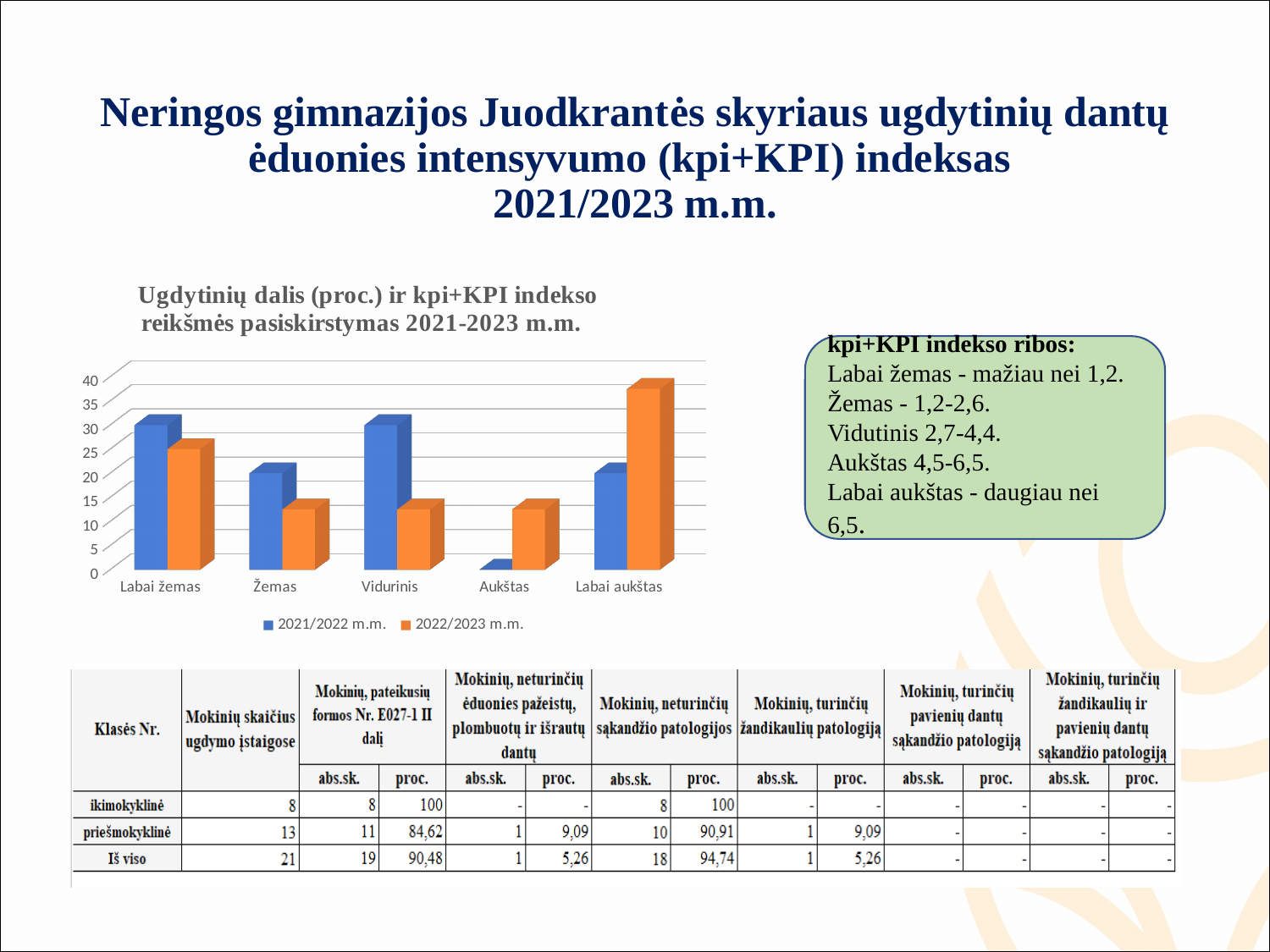
What kind of chart is shown on the slide? bar chart Is the 2022/2023 m.m. value for Labai aukštas greater or less than 30? greater Is the 2021/2022 m.m. value for Aukštas greater or less than 5? less Is the 2022/2023 m.m. value for Žemas greater or less than 20? less Which category has the highest value for the 2022/2023 m.m. series? Labai aukštas Which category has the lowest value for the 2021/2022 m.m. series? Aukštas For the Labai aukštas category, which series has the larger value, 2021/2022 m.m. or 2022/2023 m.m.? 2022/2023 m.m. How many categories are shown on the x axis of the chart? 5 For the Vidutinis category, which series has the larger value, 2021/2022 m.m. or 2022/2023 m.m.? 2021/2022 m.m. How many series does the chart legend list? 2 Which series is shown in orange in the chart legend? 2022/2023 m.m.